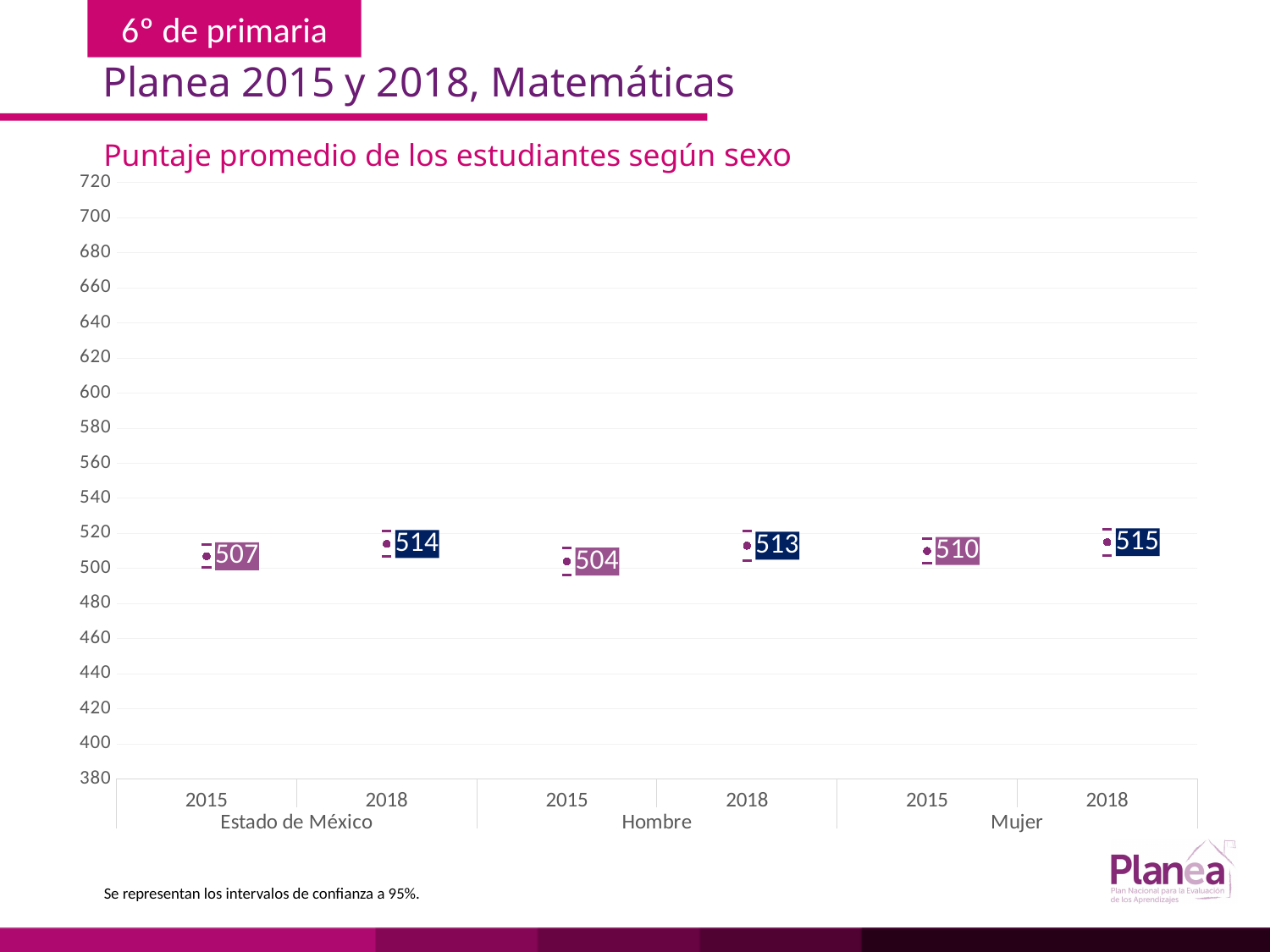
What is the average score for Mujer in 2015? 510 Is the 2015 score for Hombre greater or less than 520? less By how many points did the average score for Hombre change from 2015 to 2018? 9 What is the difference between the Mujer and Hombre average scores in 2015? 6 What is the average score for Hombre in 2018? 513 Did the average score for Estado de México rise or fall from 2015 to 2018? rise Which is larger, the 2018 score for Estado de México or the 2018 score for Hombre? Estado de México Which group and year has the lowest average score? Hombre 2015 Which group and year has the highest average score? Mujer 2018 How many data points are plotted on the chart? 6 What is the average score for Estado de México in 2015? 507 What is the average score for Mujer in 2018? 515